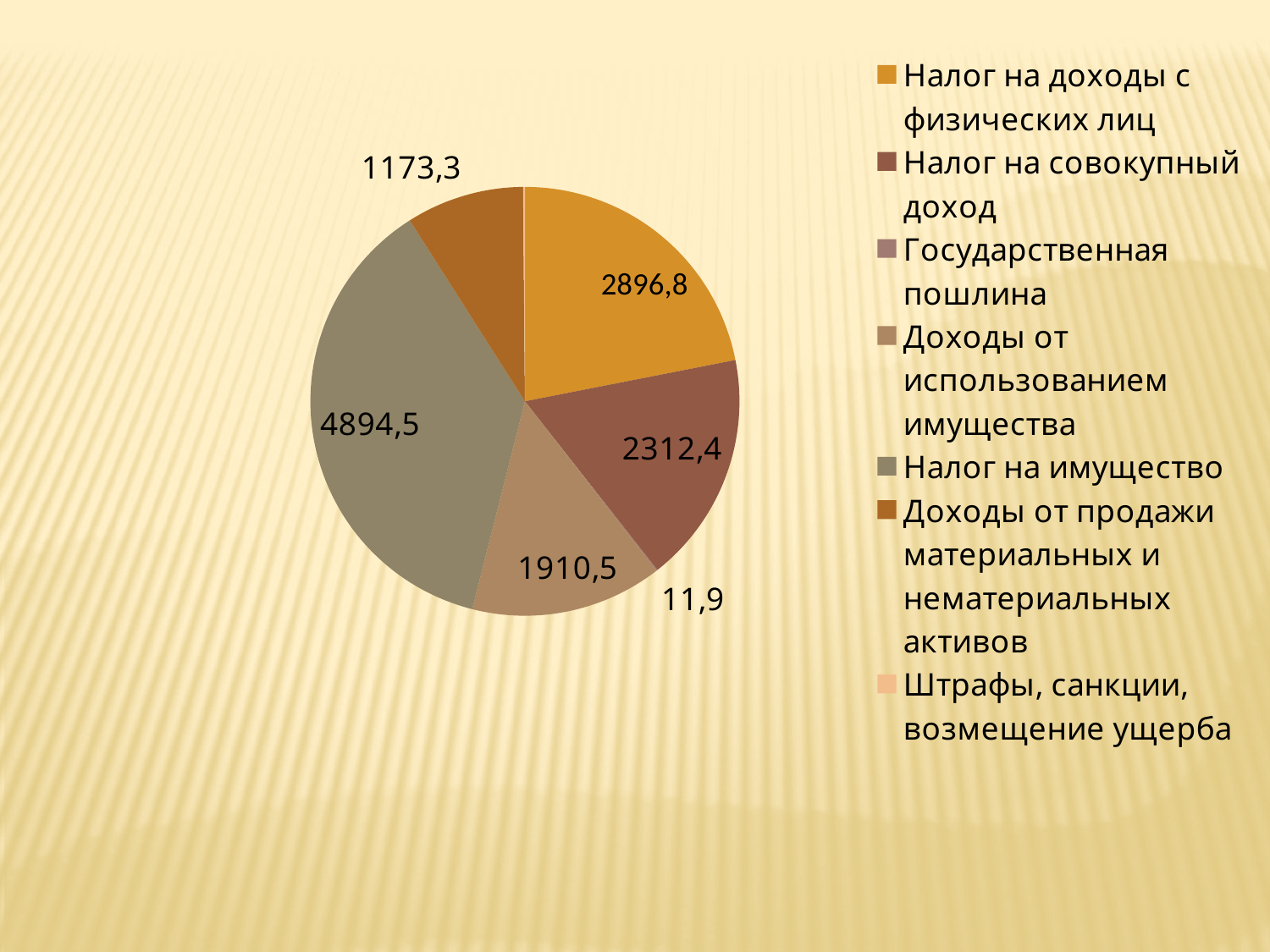
What is the value for Налог на доходы с физических лиц? 2896,8 Which is larger, the value for Налог на совокупный доход or the value for Доходы от использованием имущества? Налог на совокупный доход How many categories does the legend list? 7 Which category has the largest slice of the pie? Налог на имущество What is the value for Доходы от продажи материальных и нематериальных активов? 1173,3 What is the value for Доходы от использованием имущества? 1910,5 What is the value for Налог на имущество? 4894,5 What is the value for Налог на совокупный доход? 2312,4 What is the difference between the values for Налог на имущество and Налог на доходы с физических лиц? 1997,7 Which labelled category has the smallest value? Государственная пошлина What kind of chart is shown on the slide? pie chart What is the value for Государственная пошлина? 11,9